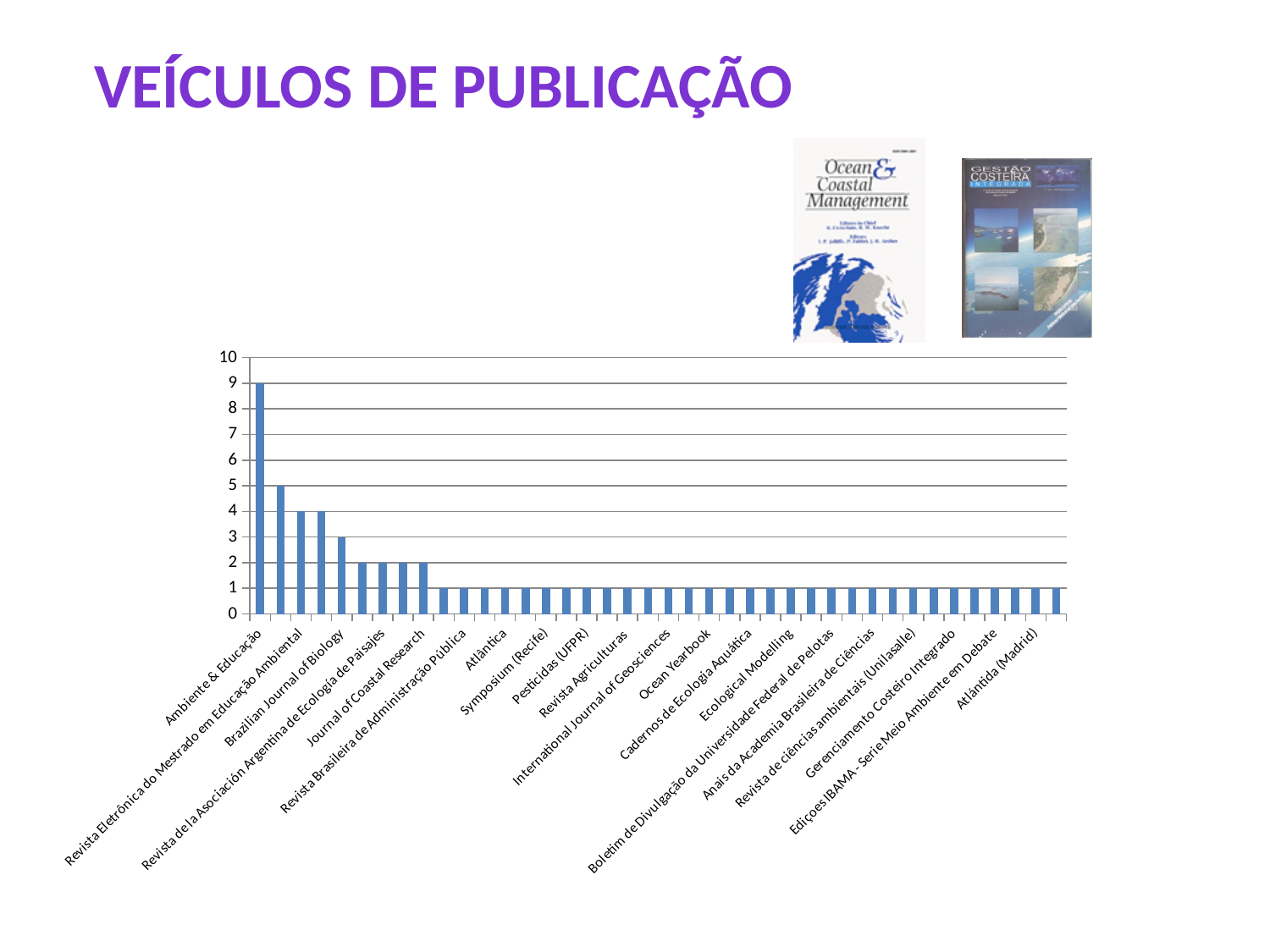
What is the value for Brazilian Journal of Biology? 3 What is the value for Atlântica? 1 Which has a larger value, Brazilian Journal of Biology or Ocean Yearbook? Brazilian Journal of Biology What is the title of the slide containing the chart? VEÍCULOS DE PUBLICAÇÃO Is the value for Ambiente & Educação greater or less than 5? greater What is the value for Revista Eletrônica do Mestrado em Educação Ambiental? 4 Which category has the highest value? Ambiente & Educação What type of chart is shown on the slide? bar chart What is the value for Journal of Coastal Research? 2 What is the value for Ambiente & Educação? 9 Do the values generally rise or fall from left to right along the x axis? fall What is the difference between the values for Ambiente & Educação and Revista Eletrônica do Mestrado em Educação Ambiental? 5